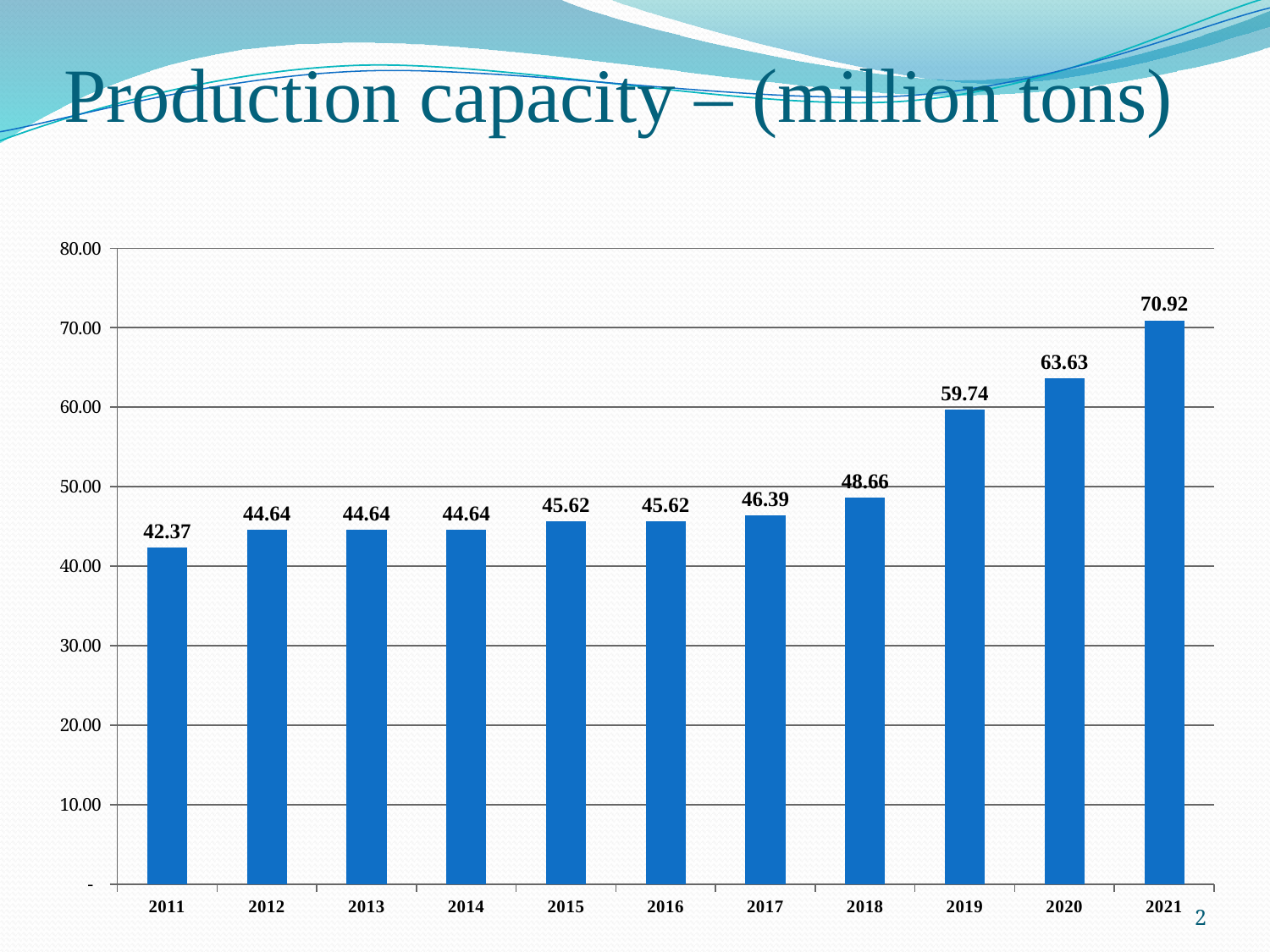
What is the production capacity for 2021? 70.92 Which year has the highest production capacity? 2021 What is the difference in production capacity between 2019 and 2018? 11.08 What is the difference in production capacity between 2021 and 2020? 7.29 Is the production capacity for 2020 greater or less than 60.00? greater What is the production capacity for 2019? 59.74 Which year has a larger production capacity, 2017 or 2018? 2018 Which year has the lowest production capacity? 2011 What kind of chart is shown on the slide? Bar chart How many years are shown on the chart? 11 Does production capacity rise or fall from 2011 to 2021? Rise What is the production capacity for 2011? 42.37